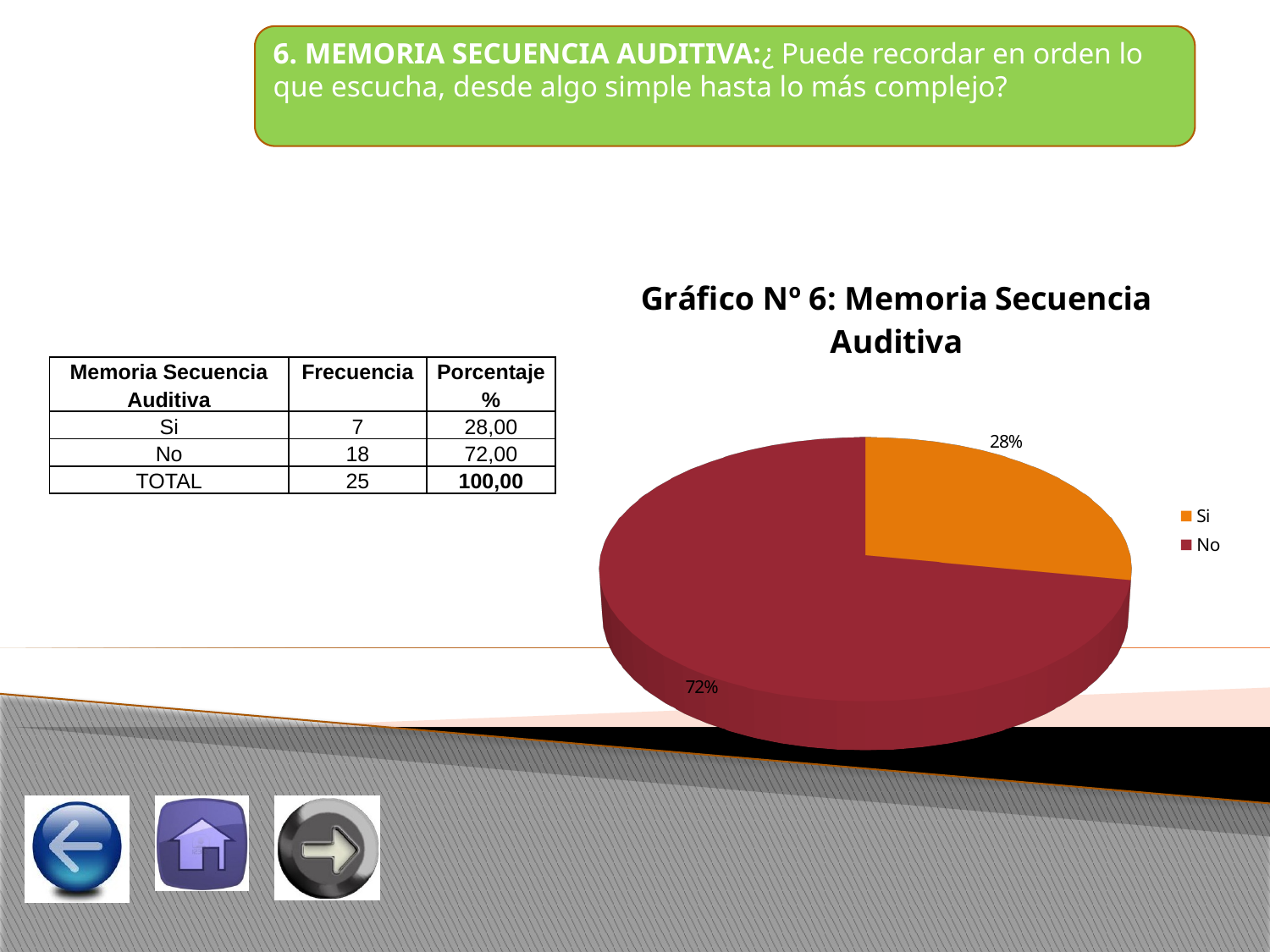
Which slice is larger, 'Si' or 'No'? No Which category has the smallest slice in the pie chart? Si What colour is the 'No' slice in the pie chart? dark red What percentage does the 'No' slice show in the pie chart? 72% How many entries does the legend list? 2 What percentage does the 'Si' slice show in the pie chart? 28% What share of the pie does the 'Si' slice represent? 28% How many slices does the pie chart have? 2 What is the title of the chart? Gráfico Nº 6: Memoria Secuencia Auditiva Which category has the largest slice in the pie chart? No What kind of chart is shown on the slide? pie chart What is the difference in percentage points between the 'No' slice and the 'Si' slice? 44